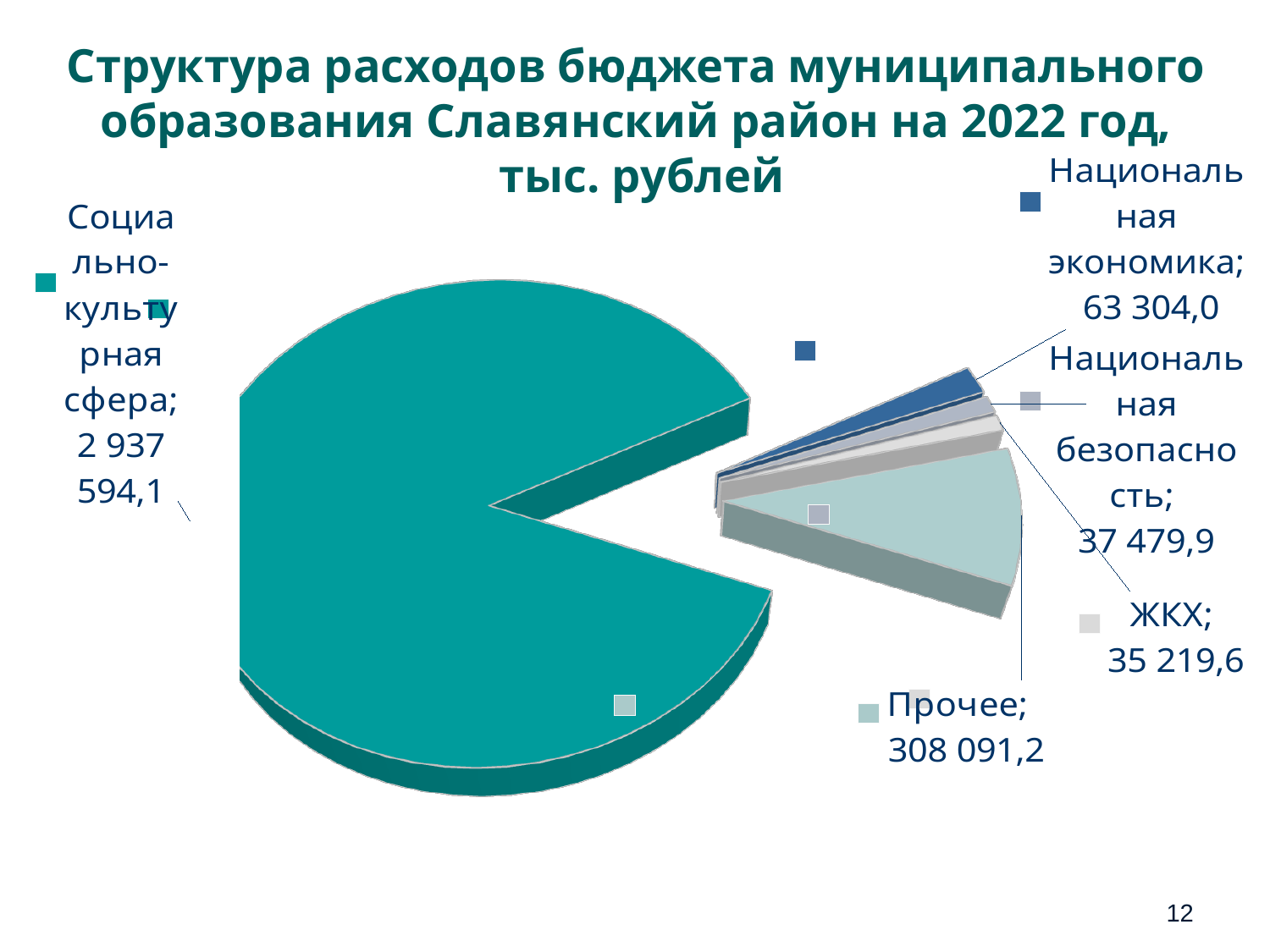
What is the value for Национальная безопасность? 37 479,9 What is the value for Национальная экономика? 63 304,0 What is the difference between the values for Национальная экономика and Национальная безопасность? 25 824,1 In what units are the values on the chart expressed, according to the title? тыс. рублей What is the value for Социально-культурная сфера? 2 937 594,1 Which category has the smallest slice of the pie? ЖКХ What is the value for Прочее? 308 091,2 What kind of chart is shown on the slide? pie chart Which category has the largest slice of the pie? Социально-культурная сфера What is the value for ЖКХ? 35 219,6 How many slices does the pie chart have? 5 Which is larger, the value for Национальная безопасность or the value for ЖКХ? Национальная безопасность